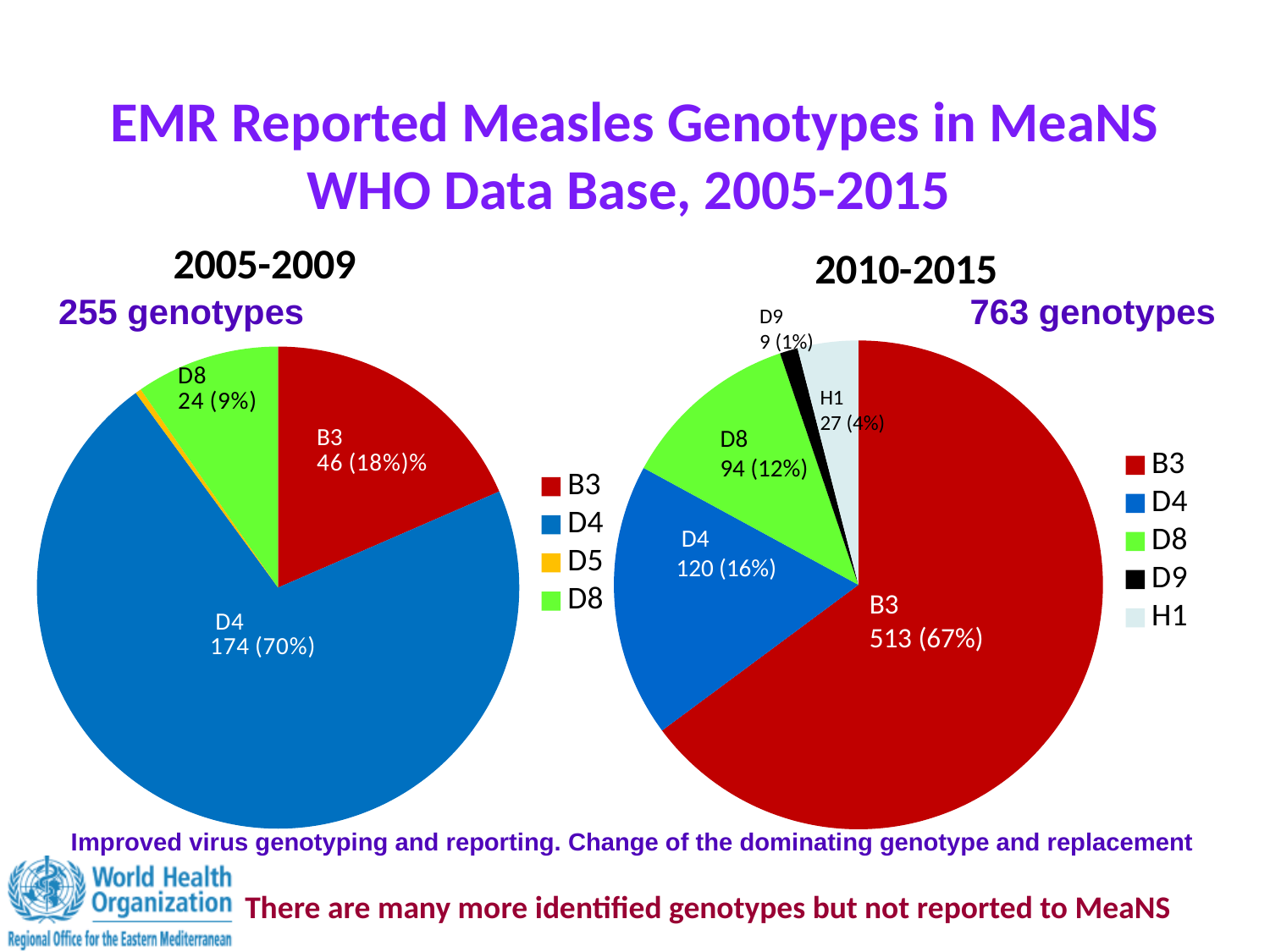
In the 2010-2015 pie chart, what is the difference between the D4 count and the D8 count? 26 In the 2005-2009 pie chart, which genotype has the largest slice? D4 How many genotypes does the legend of the 2010-2015 pie chart list? 5 In the 2005-2009 pie chart, what is the value shown for D4? 174 (70%) What share of the 2010-2015 pie does D8 represent? 12% In the 2010-2015 pie chart, which genotype has the smallest slice? D9 In the 2005-2009 pie chart, what is the value shown for B3? 46 (18%) In the 2010-2015 pie chart, which genotype has the largest slice? B3 In the 2010-2015 pie chart, what is the value shown for B3? 513 (67%) In the 2010-2015 pie chart, what is the value shown for H1? 27 (4%) In the 2005-2009 pie chart, which is larger, the B3 slice or the D8 slice? B3 What type of chart is used for the 2005-2009 data? Pie chart